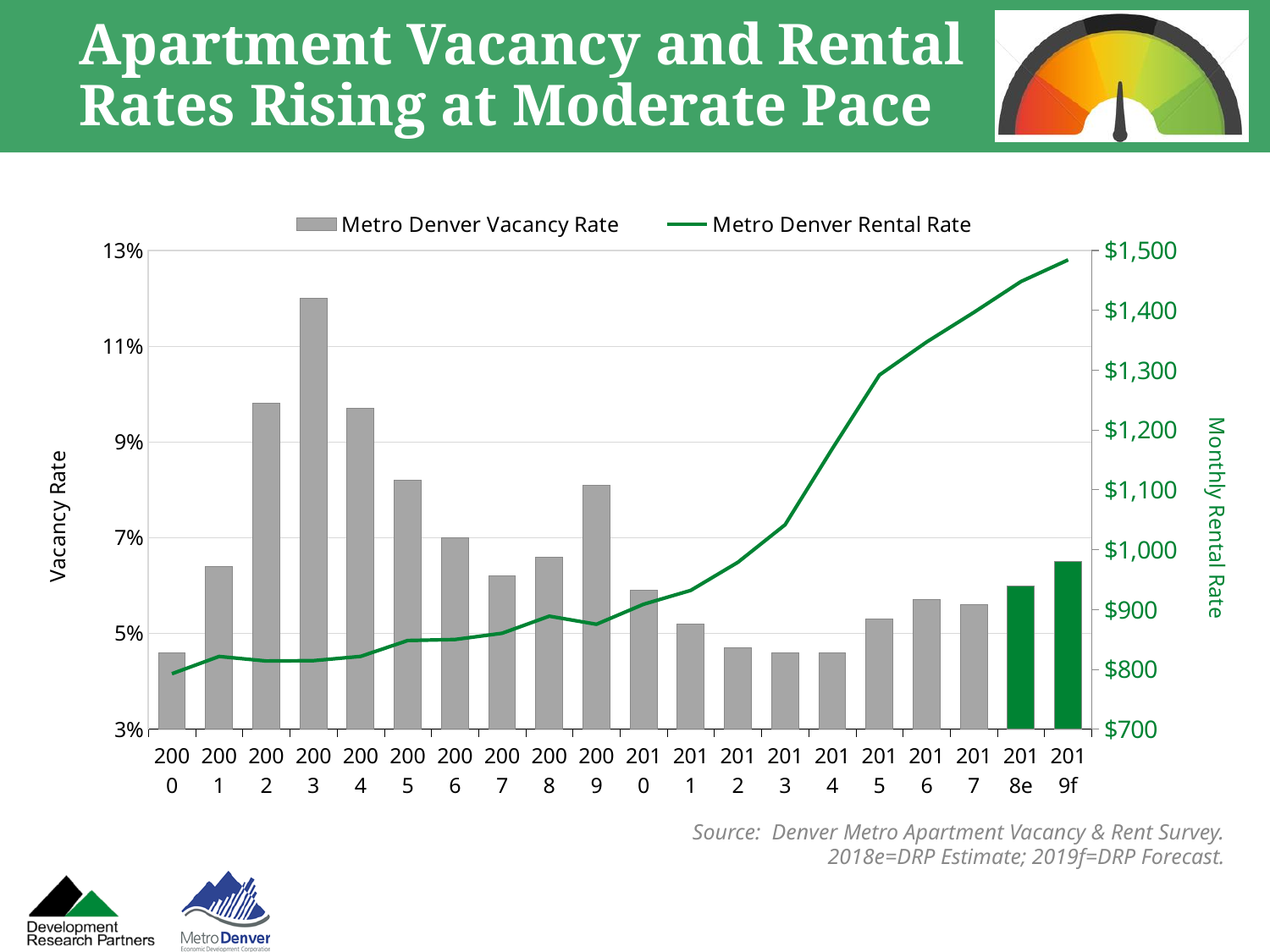
Is the Metro Denver Rental Rate for 2010 greater or less than $1,000? less Is the Metro Denver Vacancy Rate for 2003 greater or less than 11%? greater Which year has the larger Metro Denver Vacancy Rate, 2003 or 2009? 2003 What kind of chart is shown on the slide? A combination bar and line chart Does the Metro Denver Rental Rate generally rise or fall from 2000 to 2019f? Rise Which year has the highest Metro Denver Rental Rate? 2019f How many years are shown along the x axis? 20 How many series does the legend list? 2 What colour are the bars for 2018e and 2019f? Green Which year has the highest Metro Denver Vacancy Rate? 2003 What is the title of the right-hand vertical axis? Monthly Rental Rate Is the Metro Denver Rental Rate for 2019f greater or less than $1,400? greater